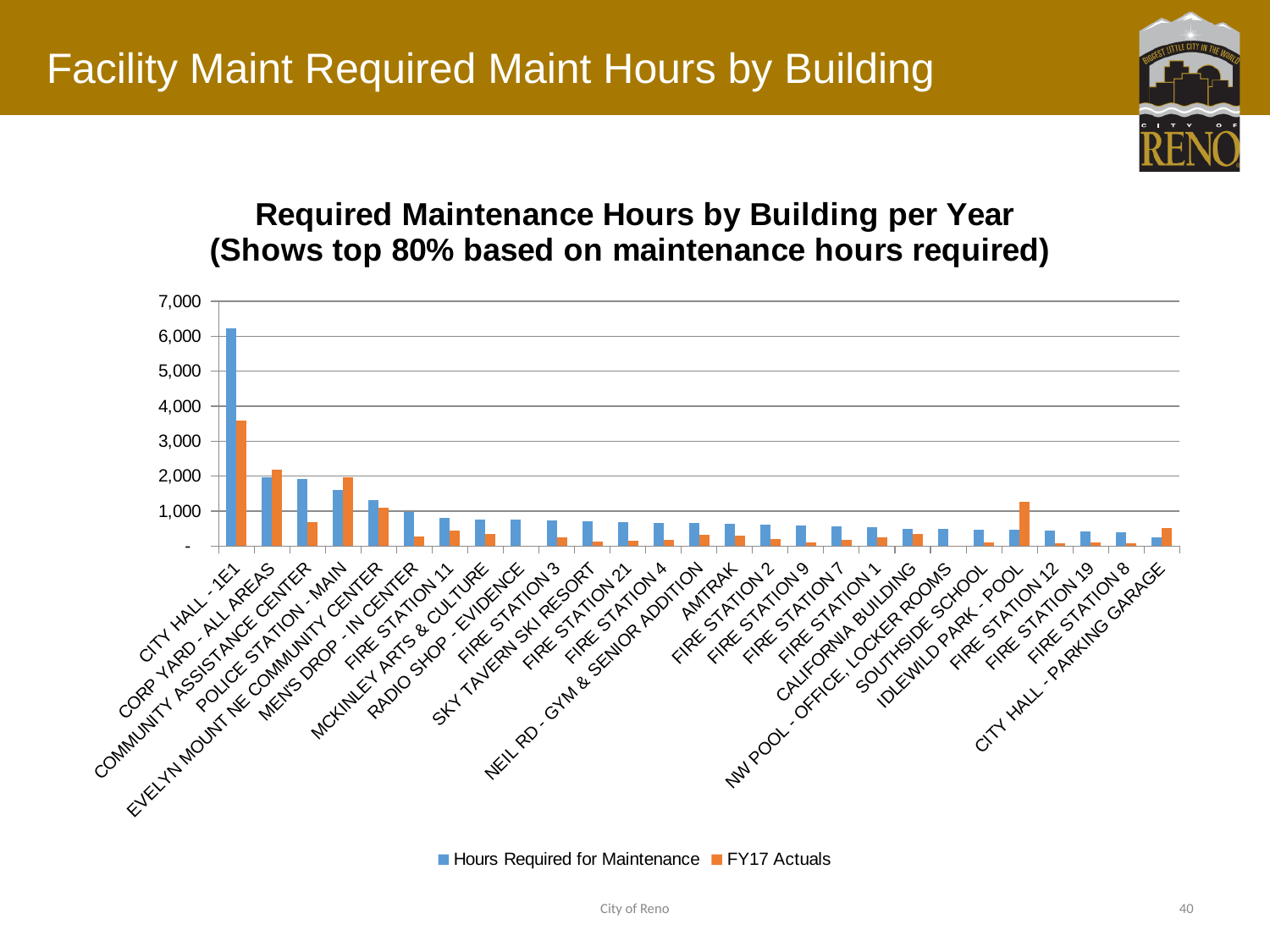
Which building has the highest FY17 Actuals? CITY HALL - 1E1 What kind of chart is shown on the slide? Bar chart Which building has the highest Hours Required for Maintenance? CITY HALL - 1E1 Which building has the larger Hours Required for Maintenance: CITY HALL - 1E1 or CORP YARD - ALL AREAS? CITY HALL - 1E1 Is the Hours Required for Maintenance value for CITY HALL - 1E1 greater or less than 5,000? greater Do the Hours Required for Maintenance values generally rise or fall from left to right along the x axis? Fall How many series does the legend list? 2 Is the FY17 Actuals value for IDLEWILD PARK - POOL greater or less than 1,000? greater Is the Hours Required for Maintenance value for FIRE STATION 11 greater or less than 1,000? less Which is larger for IDLEWILD PARK - POOL: Hours Required for Maintenance or FY17 Actuals? FY17 Actuals What are the two series named in the legend? Hours Required for Maintenance and FY17 Actuals